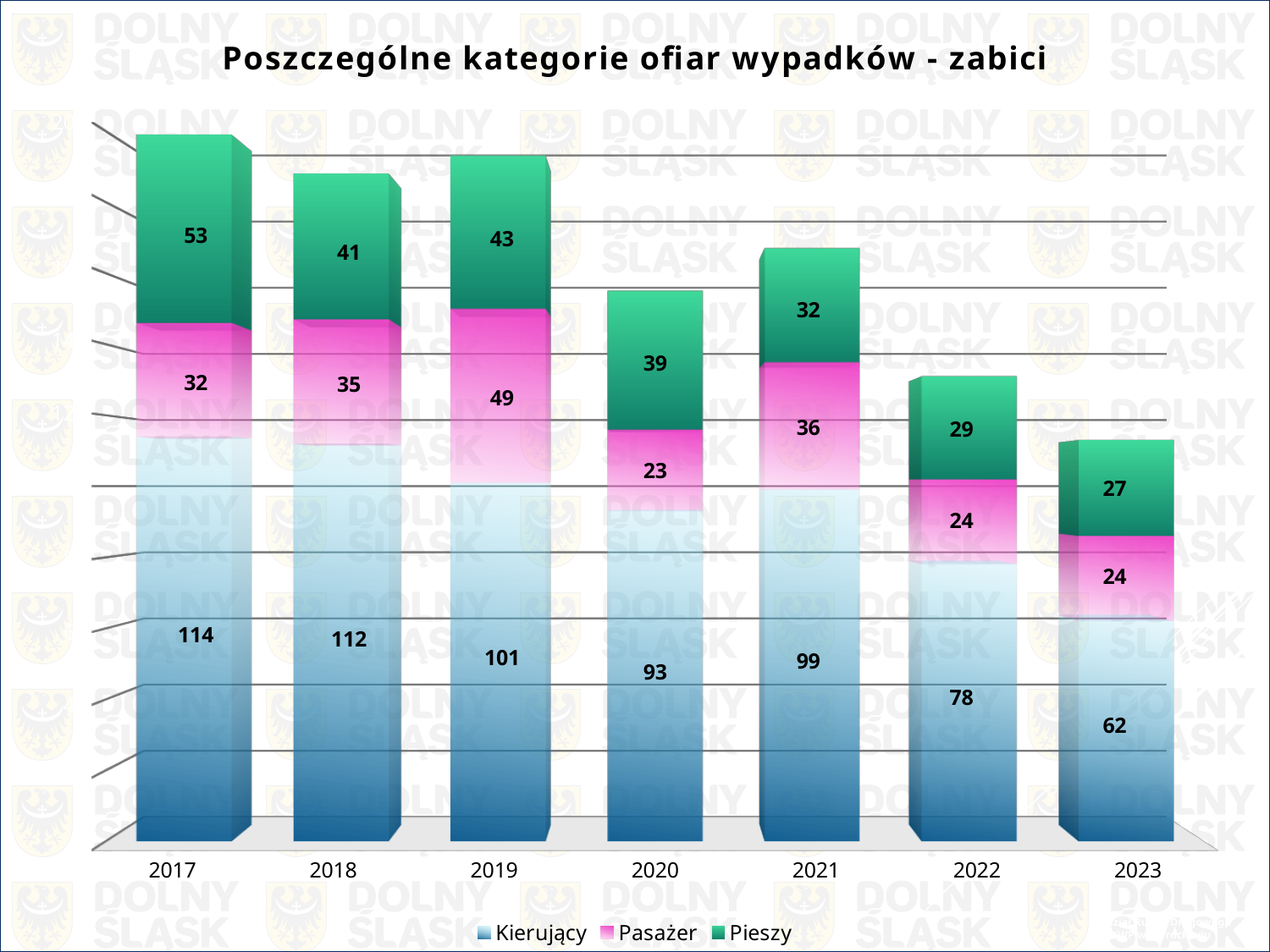
In which year is the Kierujący value the lowest? 2023 In which year is the Pieszy value the highest? 2017 What is the value for Pasażer in 2019? 49 How many years are shown on the x axis? 7 What is the value for Kierujący in 2017? 114 What is the value for Pieszy in 2022? 29 How many series does the legend list? 3 What is the difference between the Kierujący values for 2017 and 2023? 52 What type of chart is shown on the slide? stacked bar chart What is the total of the stacked bar for 2020? 155 Which is larger, the Pasażer value in 2021 or the Pieszy value in 2021? Pasażer (36) What is the title of the chart? Poszczególne kategorie ofiar wypadków - zabici